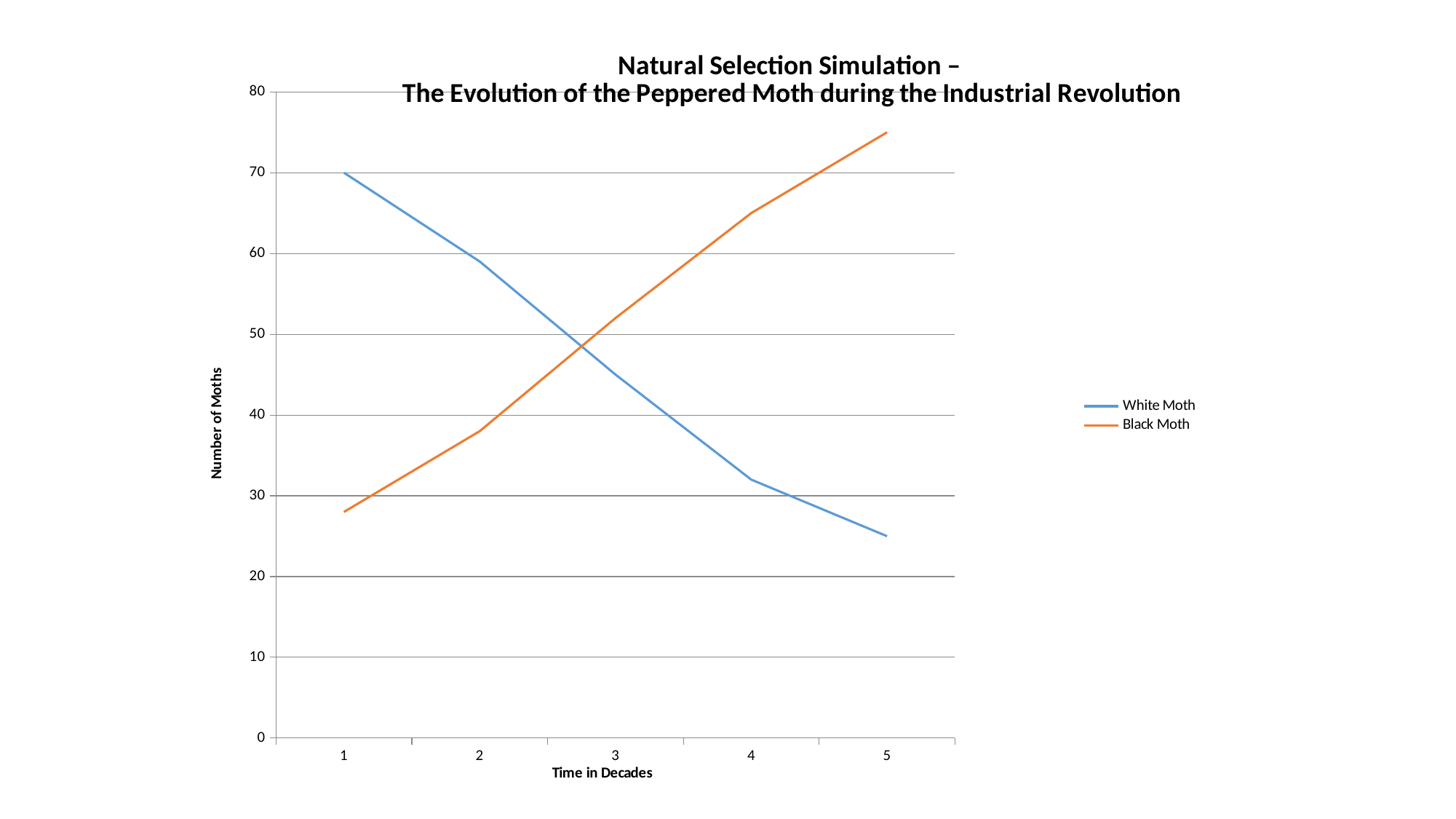
Does the White Moth line rise or fall from decade 1 to decade 5? fall Is the value for White Moth at decade 5 greater or less than 30? less How many series does the legend list? 2 Is the value for Black Moth at decade 1 greater or less than 30? less At which decade is the White Moth value highest? 1 How many time points (decades) are plotted along the x axis? 5 At decade 4, which series has the larger value, White Moth or Black Moth? Black Moth Is the value for Black Moth at decade 5 greater or less than 70? greater What is the title of the vertical axis? Number of Moths What is the number of White Moths at decade 1? 70 Does the Black Moth line rise or fall from decade 1 to decade 5? rise What kind of chart is shown on the slide? line chart